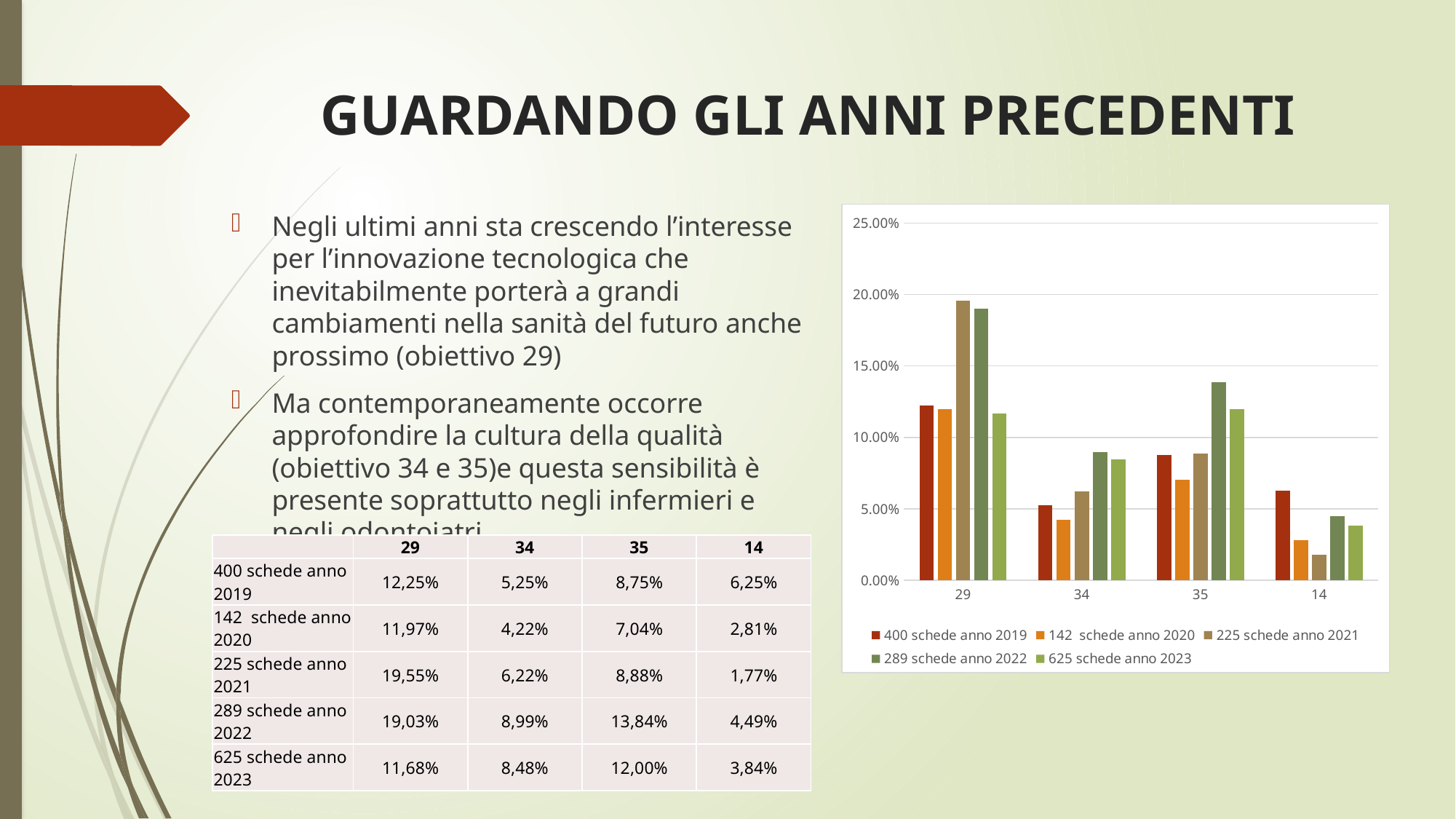
Which series and category has the tallest bar in the chart? 225 schede anno 2021 at category 29 At category 35, which series has the larger value: '289 schede anno 2022' or '625 schede anno 2023'? 289 schede anno 2022 For the series '225 schede anno 2021', which category has the highest value? 29 Is the value for category 29 in the series '225 schede anno 2021' greater or less than 15.00%? greater Is the value for category 14 in the series '142 schede anno 2020' greater or less than 5.00%? less What is the value for category 35 in the series '289 schede anno 2022'? 13,84% How many categories are shown on the x axis of the chart? 4 How many series does the chart legend list? 5 For the series '225 schede anno 2021', which category has the lowest value? 14 What kind of chart is shown on the slide? bar chart In the series '400 schede anno 2019', what is the difference between the value for category 29 and the value for category 34? 7,00% What is the value for category 29 in the series '400 schede anno 2019'? 12,25%